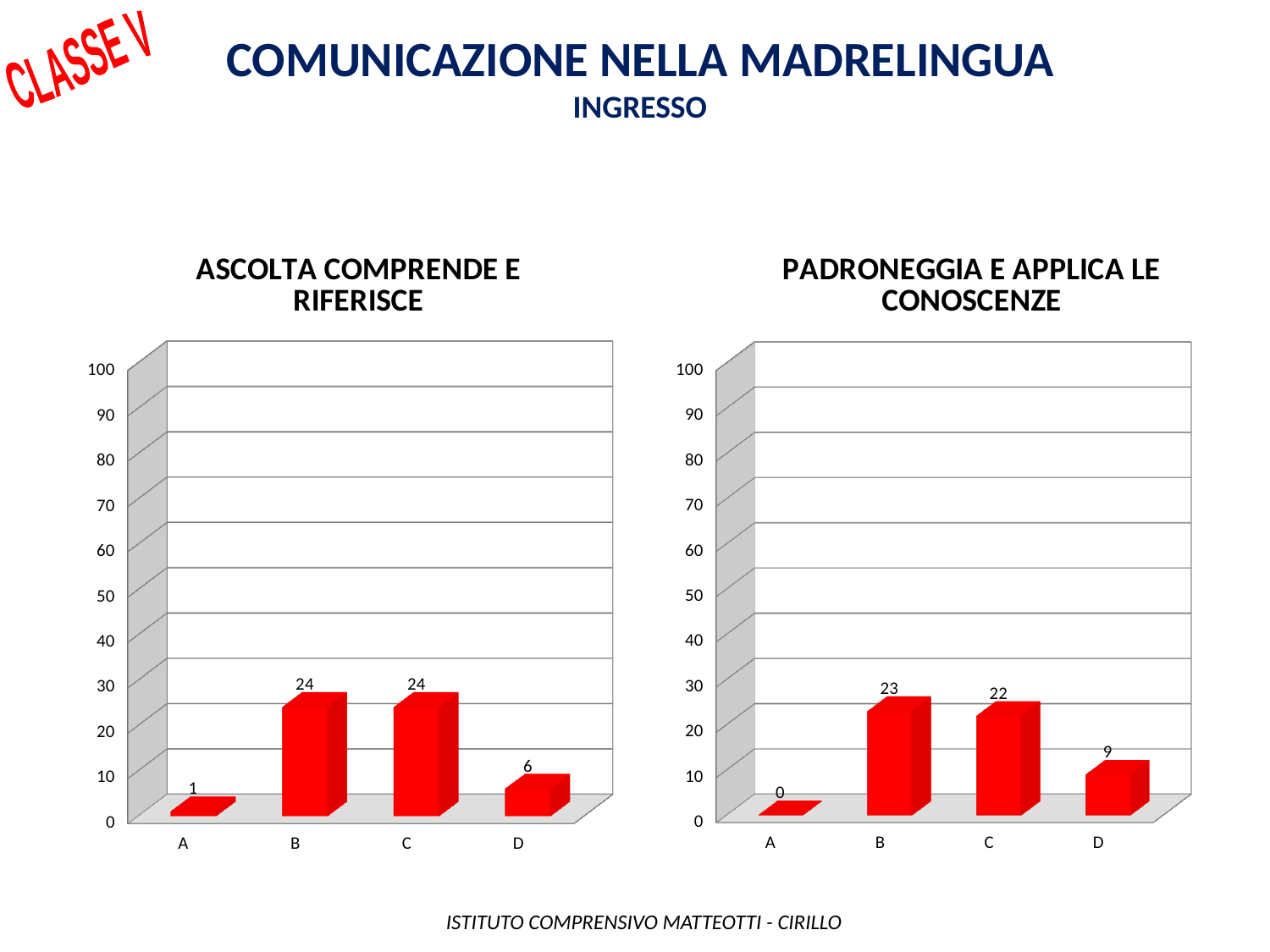
How many categories are shown in the 'ASCOLTA COMPRENDE E RIFERISCE' chart? 4 In the 'PADRONEGGIA E APPLICA LE CONOSCENZE' chart, which category has the highest value? B What is the title of the chart on the left of the slide? ASCOLTA COMPRENDE E RIFERISCE What kind of chart is the 'PADRONEGGIA E APPLICA LE CONOSCENZE' chart? Bar chart In the 'PADRONEGGIA E APPLICA LE CONOSCENZE' chart, which is larger, the value for C or the value for D? C In the 'ASCOLTA COMPRENDE E RIFERISCE' chart, what is the value for category B? 24 In the 'PADRONEGGIA E APPLICA LE CONOSCENZE' chart, what is the value for category A? 0 In the 'PADRONEGGIA E APPLICA LE CONOSCENZE' chart, what is the value for category B? 23 In the 'ASCOLTA COMPRENDE E RIFERISCE' chart, what is the value for category D? 6 In the 'ASCOLTA COMPRENDE E RIFERISCE' chart, what is the difference between the values for C and D? 18 In the 'ASCOLTA COMPRENDE E RIFERISCE' chart, which category has the lowest value? A In the 'PADRONEGGIA E APPLICA LE CONOSCENZE' chart, what is the difference between the values for B and D? 14